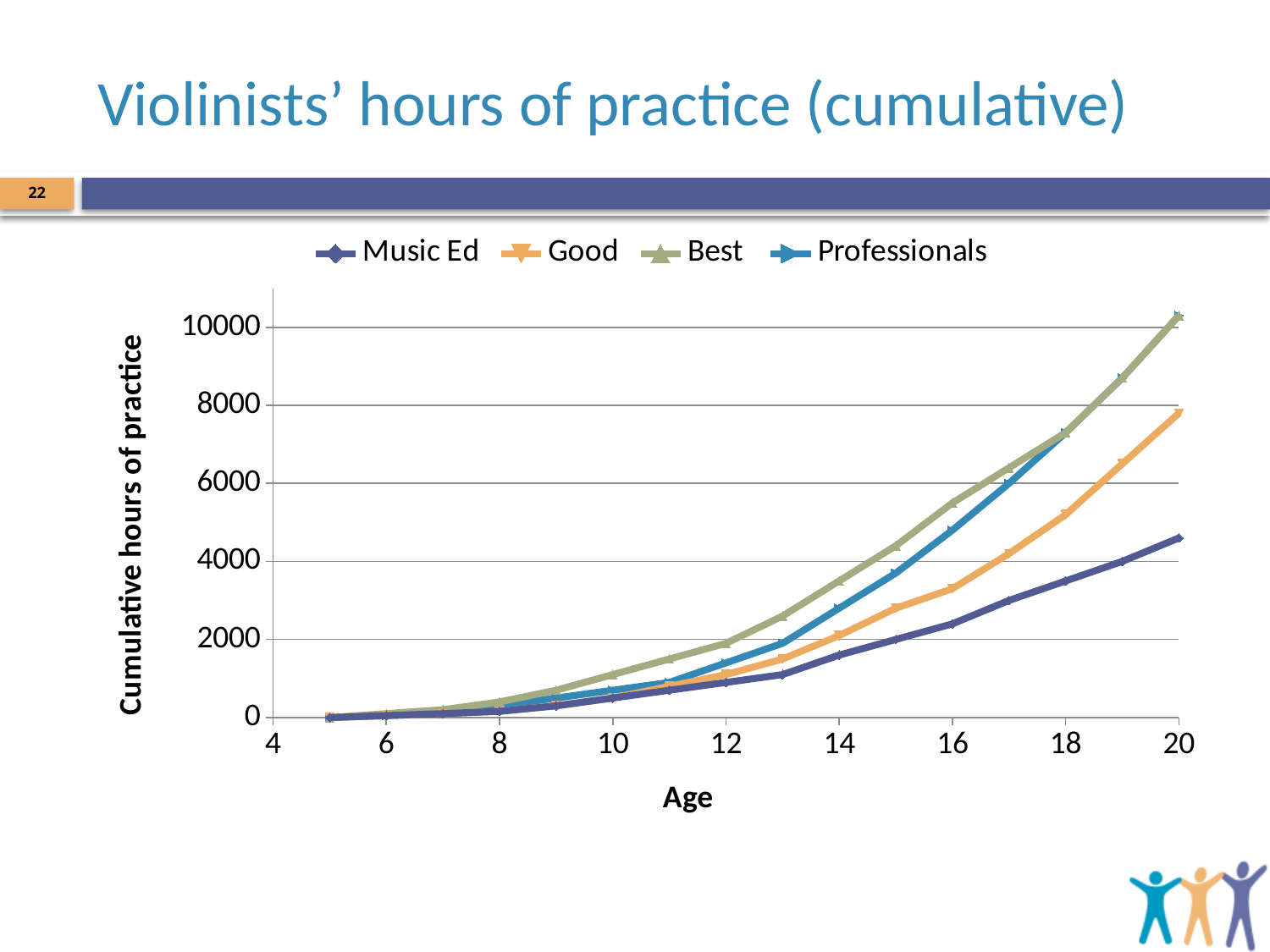
Is the value for Good at age 20 greater or less than 6000? greater Is the value for Best at age 16 greater or less than 4000? greater Is the value for Professionals at age 14 greater or less than 4000? less Which series has the lowest value at age 20? Music Ed At age 20, which is larger, the value for Good or the value for Music Ed? Good What is the title of the chart? Violinists' hours of practice (cumulative) Do the cumulative hours of practice rise or fall as age increases? rise How many series does the legend list? 4 What is the label on the vertical axis? Cumulative hours of practice What kind of chart is shown on the slide? line chart At age 16, which is larger, the value for Best or the value for Professionals? Best